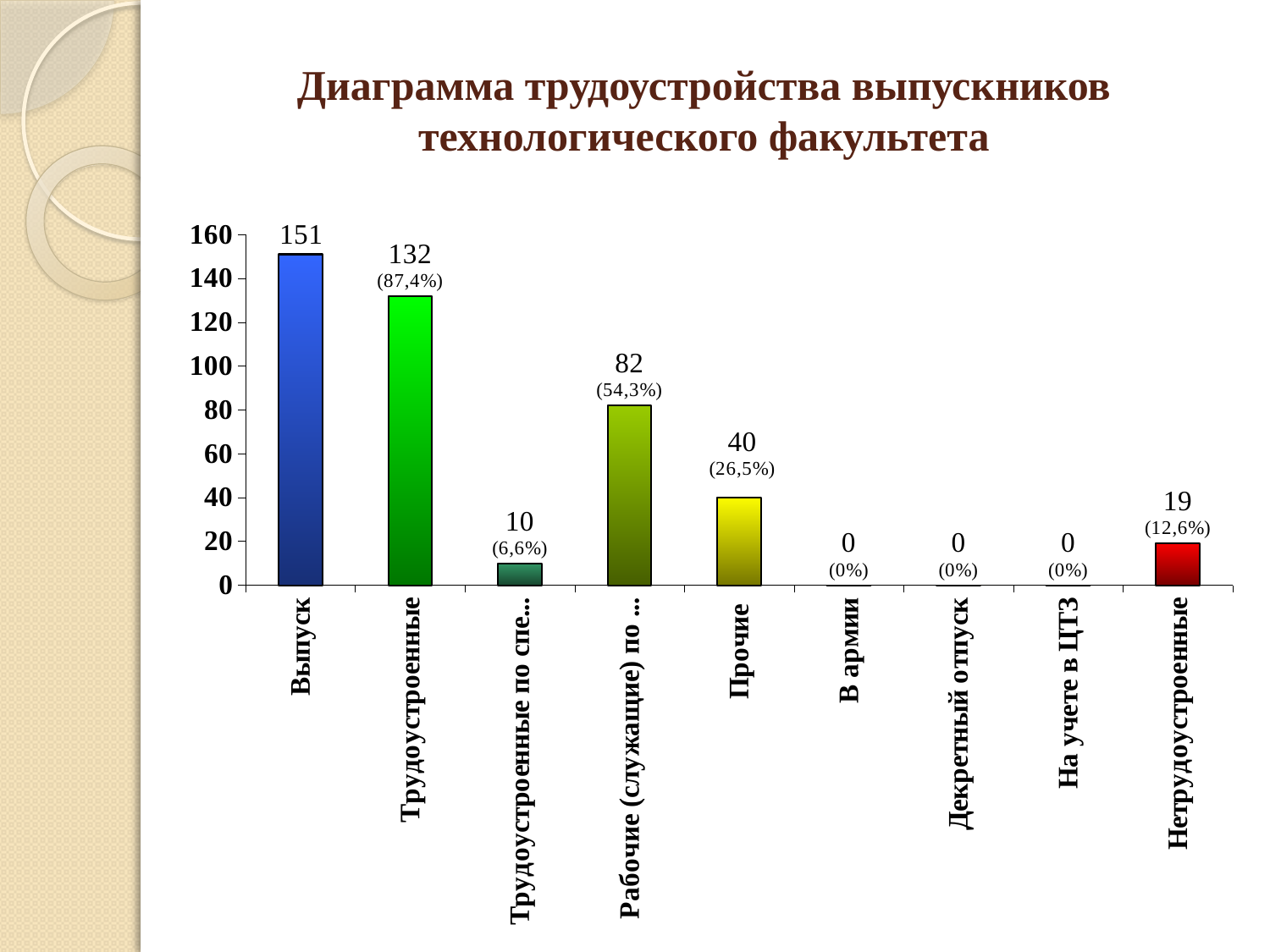
What is the value for Трудоустроенные? 132 What is the value for Декретный отпуск? 0 What is the title of the chart? Диаграмма трудоустройства выпускников технологического факультета What is the value for Прочие? 40 What percentage is shown for Прочие? 26,5% What is the difference between the values for Выпуск and Трудоустроенные? 19 How many categories are shown on the x axis? 9 Which category has the highest value? Выпуск What kind of chart is shown on the slide? bar chart Which is larger, the value for Прочие or the value for Нетрудоустроенные? Прочие What is the value for Выпуск? 151 What percentage is shown for Нетрудоустроенные? 12,6%